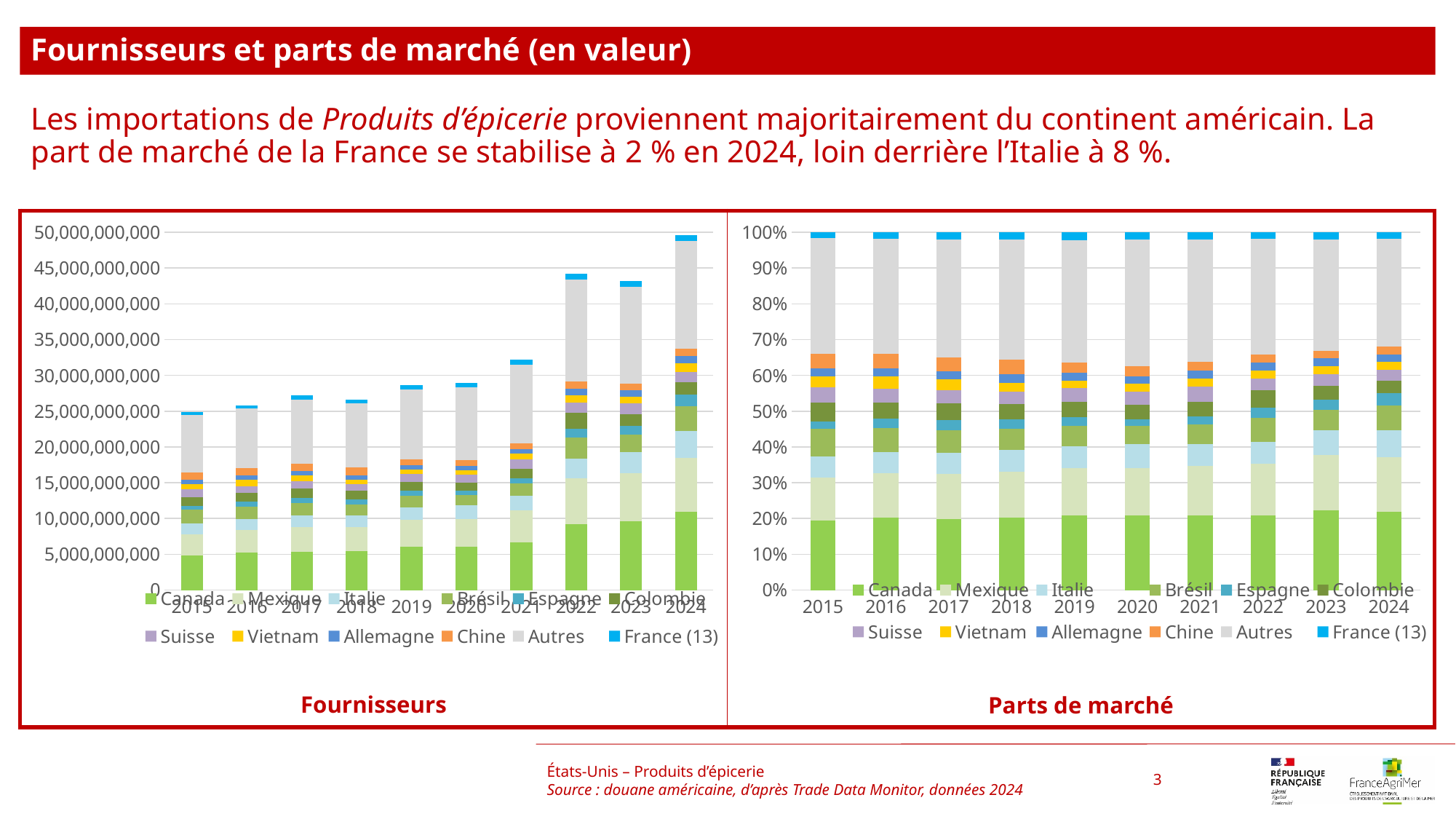
In the 'Fournisseurs' chart, do the total bars generally rise or fall from 2015 to 2024? rise In the 'Fournisseurs' chart, is the total for 2015 greater or less than 30,000,000,000? less In the 'Fournisseurs' chart, how many years are shown on the x axis? 10 Which legend entry in the 'Fournisseurs' chart is listed last? France (13) What kind of chart is the 'Fournisseurs' chart on the left? stacked bar chart In the 'Fournisseurs' chart, which year has the lowest total bar? 2015 In the 'Fournisseurs' chart, which year has the larger total bar, 2021 or 2022? 2022 In the 'Parts de marché' chart, is the Canada share in 2015 greater or less than 30%? less What kind of chart is the 'Parts de marché' chart on the right? 100% stacked bar chart In the 'Parts de marché' chart, how many series does the legend list? 12 In the 'Fournisseurs' chart, is the total for 2024 greater or less than 45,000,000,000? greater In the 'Fournisseurs' chart, which year has the highest total bar? 2024